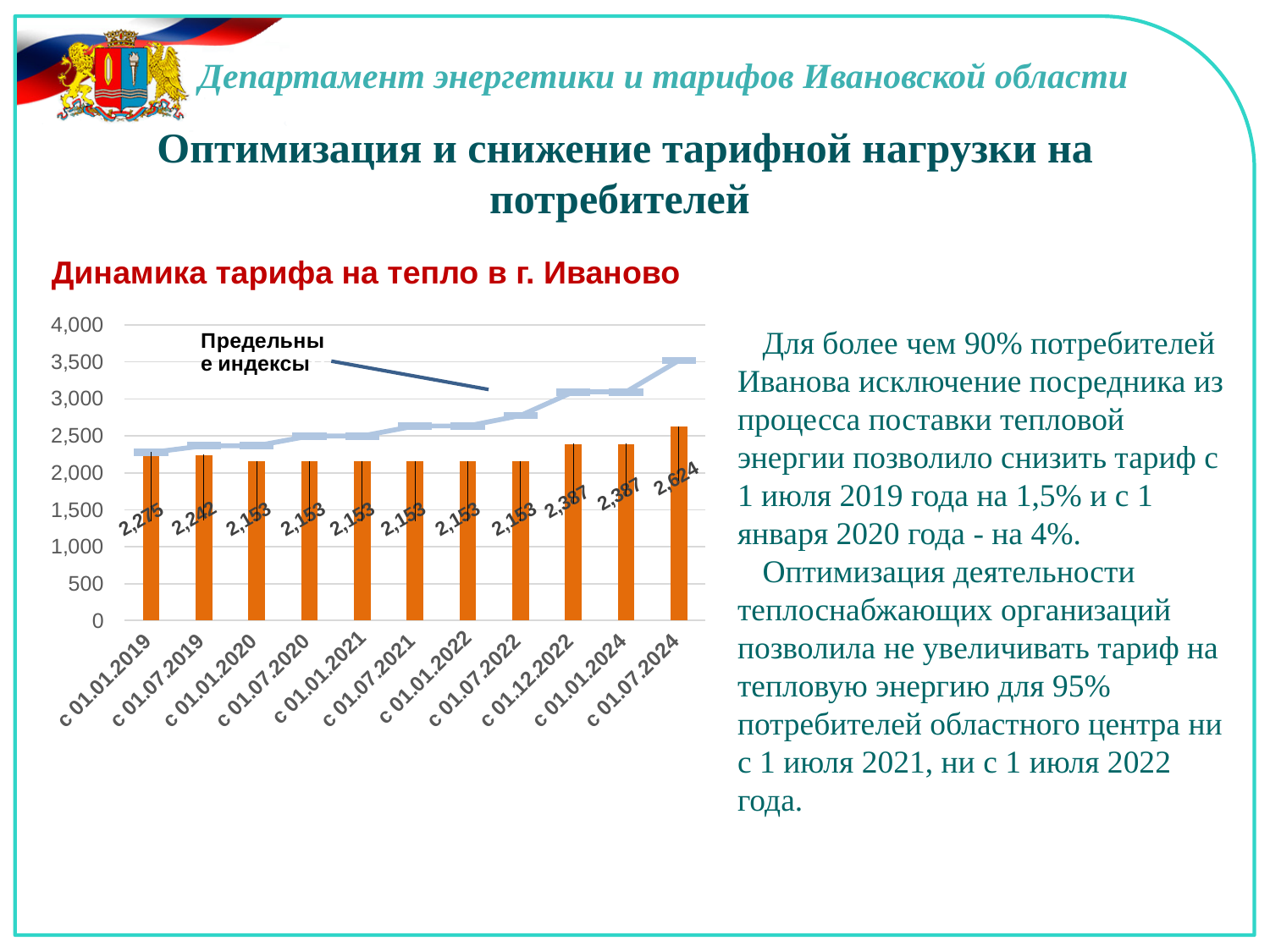
Which is larger, the tariff for с 01.01.2019 or for с 01.01.2020? с 01.01.2019 What is the tariff value for с 01.12.2022? 2,387 What is the difference between the tariff for с 01.07.2024 and с 01.01.2024? 237 How many date categories are shown on the x axis? 11 What kind of chart is used to show the tariff values? bar chart What is the tariff value for с 01.01.2019? 2,275 What is the lowest tariff value shown on the bars? 2,153 What is the tariff value for с 01.07.2024? 2,624 Is the value of the Предельные индексы line for с 01.07.2024 greater or less than 3,000? greater What is the difference between the tariff for с 01.01.2019 and с 01.07.2019? 33 Which category has the highest tariff bar? с 01.07.2024 What is the title of the chart? Динамика тарифа на тепло в г. Иваново